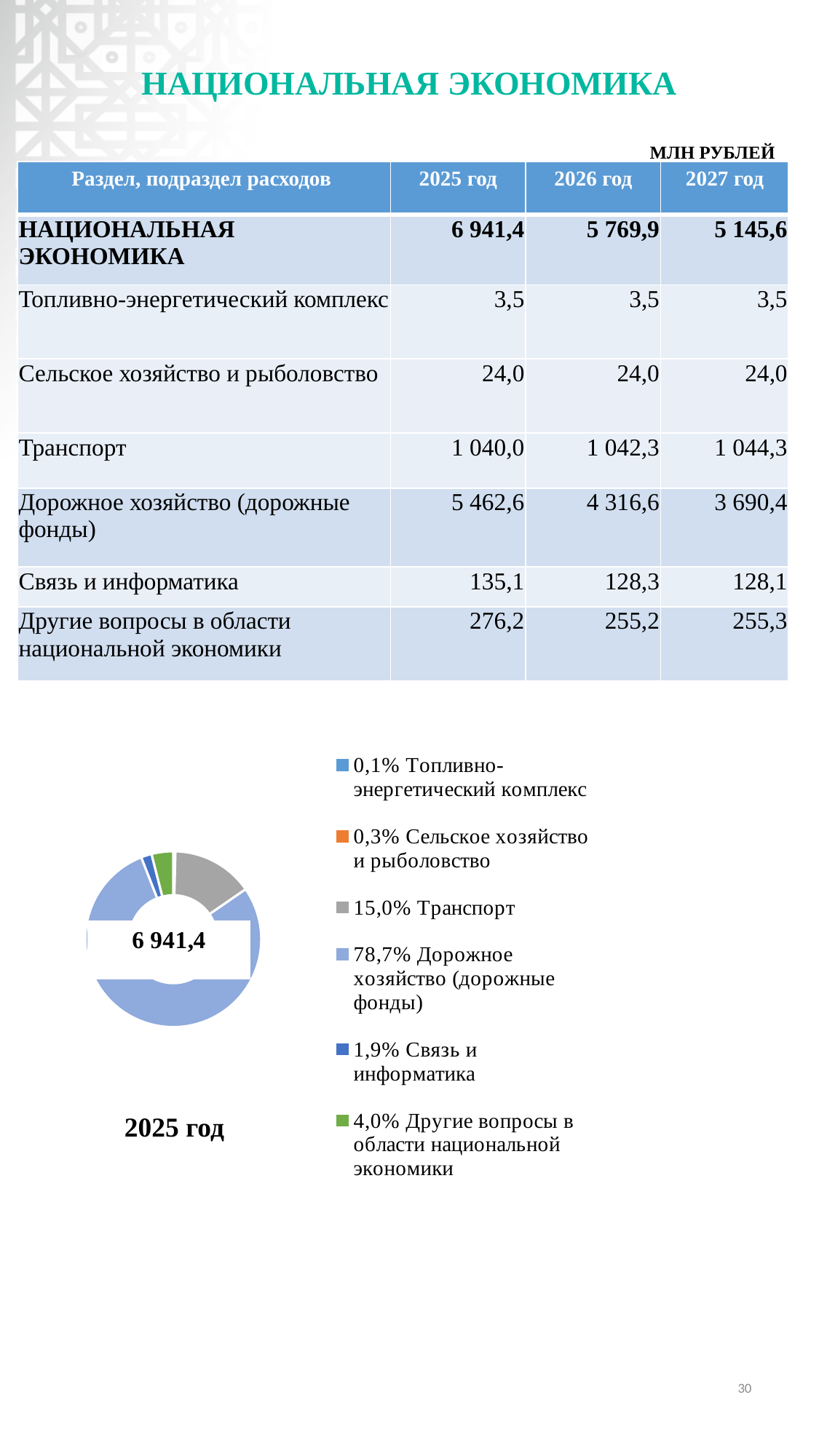
How many categories does the chart's legend list? 6 Which category has the largest share in the chart? Дорожное хозяйство (дорожные фонды) Which year does the chart represent, according to the label beneath it? 2025 год What share of the chart does Топливно-энергетический комплекс account for? 0,1% What kind of chart is shown on the slide? doughnut (pie) chart Which category has the smallest share in the chart? Топливно-энергетический комплекс What total value is printed in the centre of the chart? 6 941,4 What share of the chart does Транспорт account for? 15,0% What share of the chart does Дорожное хозяйство (дорожные фонды) account for? 78,7% Which has a larger share in the chart, Транспорт or Другие вопросы в области национальной экономики? Транспорт